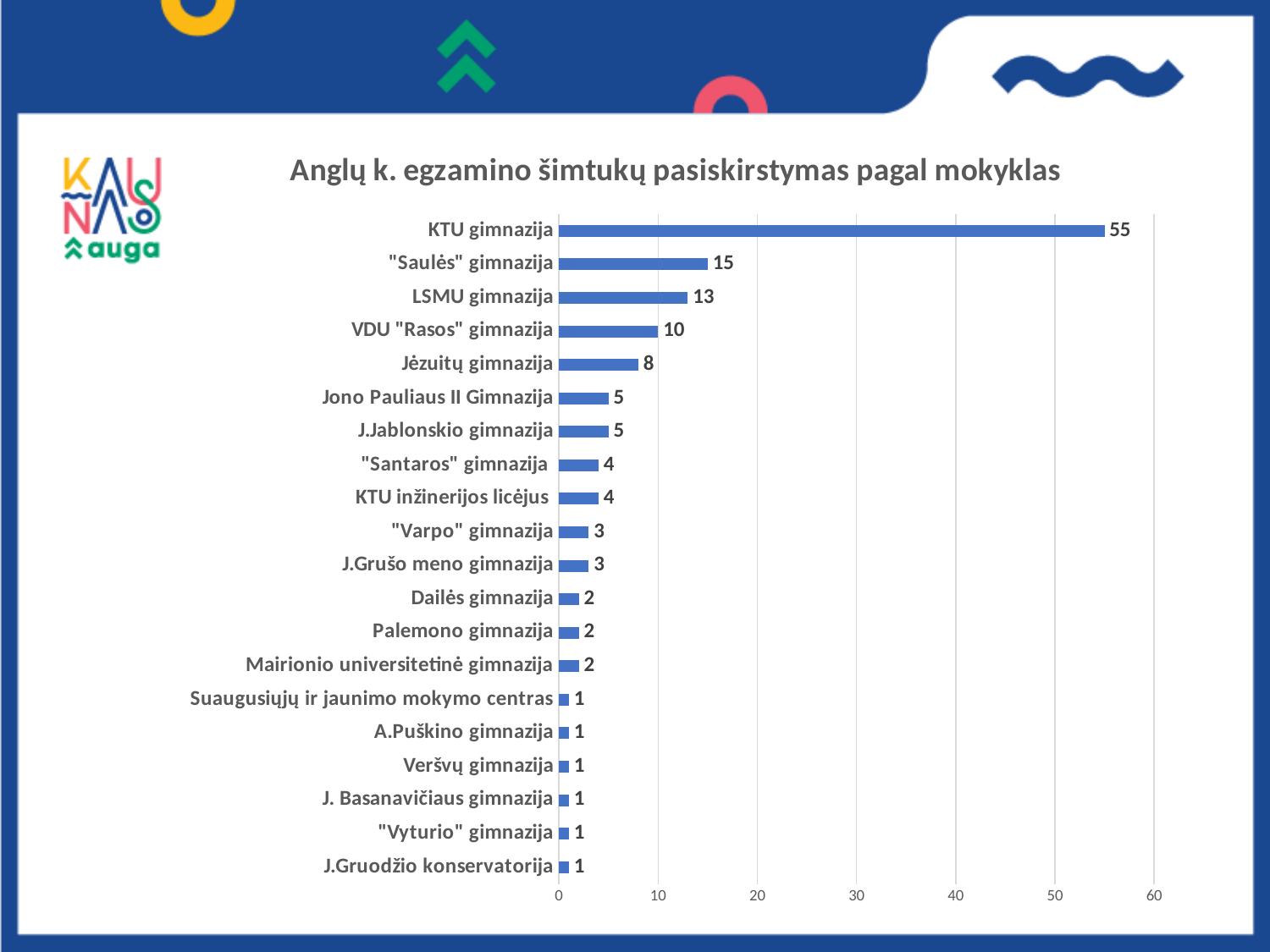
What is the value for "Santaros" gimnazija? 4 What kind of chart is shown on the slide? bar chart Is the value for KTU gimnazija greater or less than 50? greater What is the value for Jėzuitų gimnazija? 8 How many schools are shown in the chart? 20 What is the value for KTU gimnazija? 55 What is the difference between the values for VDU "Rasos" gimnazija and Jėzuitų gimnazija? 2 What is the difference between the values for KTU gimnazija and "Saulės" gimnazija? 40 What is the value for LSMU gimnazija? 13 What is the title of the chart? Anglų k. egzamino šimtukų pasiskirstymas pagal mokyklas Which is larger, the value for "Saulės" gimnazija or the value for LSMU gimnazija? "Saulės" gimnazija Which school has the highest value? KTU gimnazija